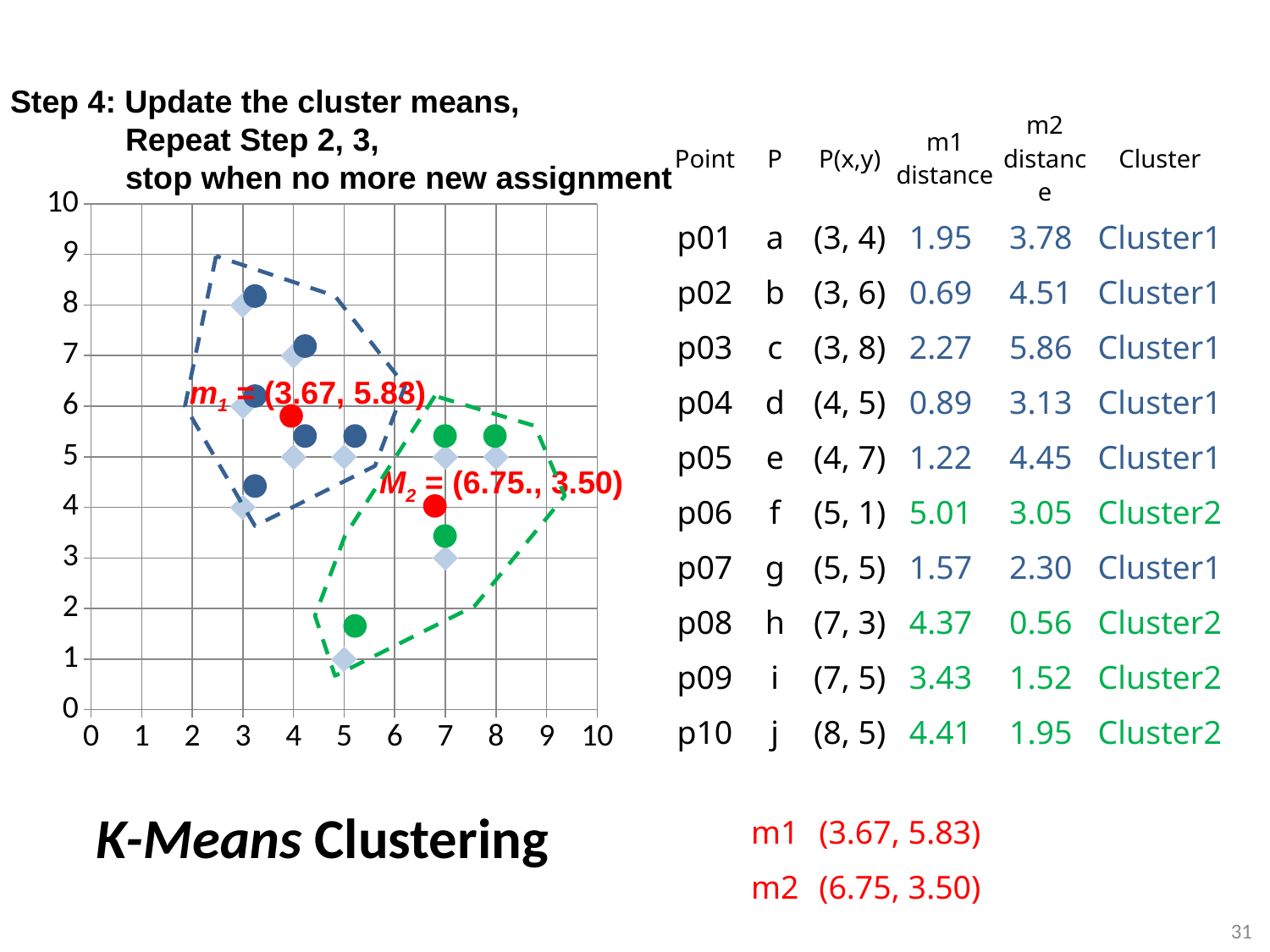
What are the coordinates of the cluster mean m1 labelled on the chart? (3.67, 5.83) Which point has the largest x value on the scatter chart? j (8, 5) What is the maximum value shown on the x axis of the scatter chart? 10 Which has the larger x value, point h (7, 3) or point d (4, 5)? h (7, 3) What kind of chart is shown on the left of the slide? scatter chart Which point has the lowest y value on the scatter chart? f (5, 1) How many data points (diamonds) are plotted on the scatter chart? 10 What are the coordinates of the cluster mean m2 labelled on the chart? (6.75, 3.50) What is the difference in y value between the highest point (3, 8) and the lowest point (5, 1)? 7 Which point has the highest y value on the scatter chart? c (3, 8) Is the y value of the cluster mean m1 greater or less than 5? greater Is the x value of the cluster mean m2 greater or less than 6? greater